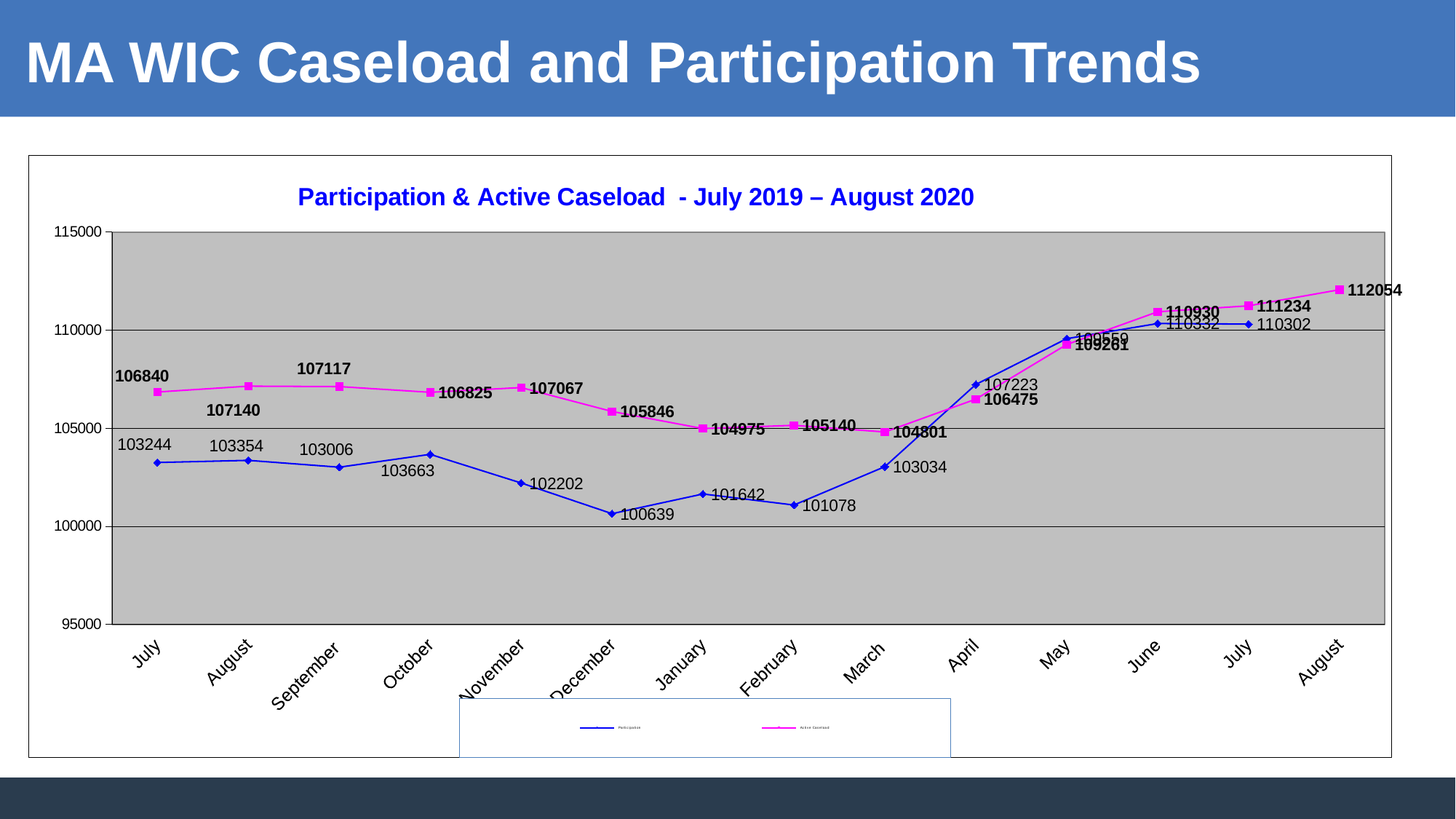
What is the Active Caseload value for March? 104801 In which month is Participation lowest? December How many series does the chart's legend list? 2 What is the difference between the Active Caseload values for August 2020 and July 2020? 820 What kind of chart is shown on the slide? Line chart What is the Participation value for December? 100639 What is the Active Caseload value for the final August (August 2020)? 112054 In which month is Active Caseload highest? August (2020) Which is larger, Participation in October or Participation in September? October What is the difference between Active Caseload and Participation in the first July (July 2019)? 3596 Is the Participation value for April greater or less than 105000? greater How many months are shown along the x axis of the chart? 14